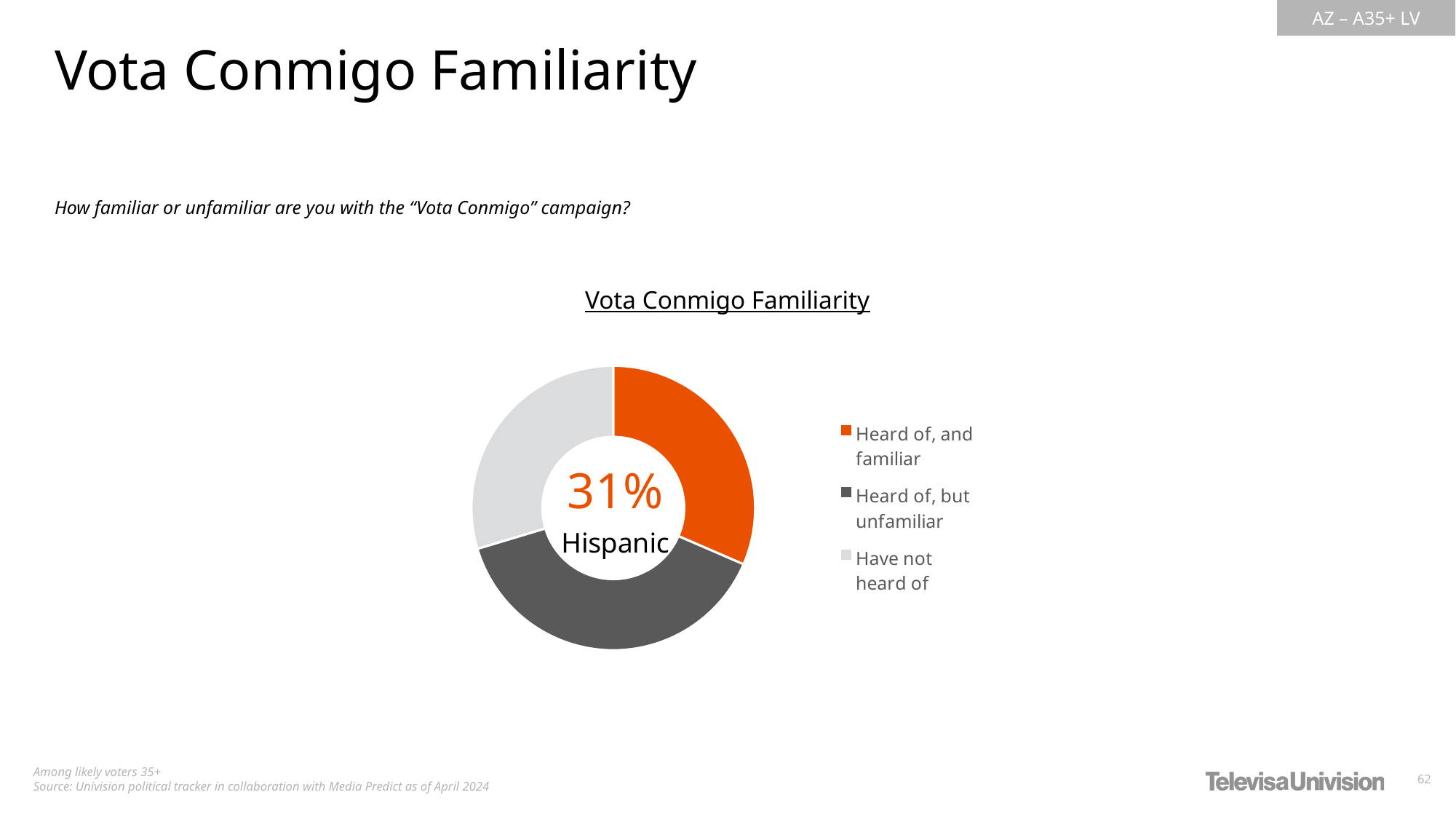
Which legend entry is shown in orange? Heard of, and familiar What is the title of the chart? Vota Conmigo Familiarity What percentage is printed in the centre of the donut chart? 31% Which category has the largest slice in the Vota Conmigo Familiarity chart? Heard of, but unfamiliar What kind of chart is shown on the slide? Pie chart (donut) What group label is printed in the centre of the donut chart below the percentage? Hispanic Which slice is larger: "Heard of, but unfamiliar" or "Heard of, and familiar"? Heard of, but unfamiliar How many categories does the legend of the Vota Conmigo Familiarity chart list? 3